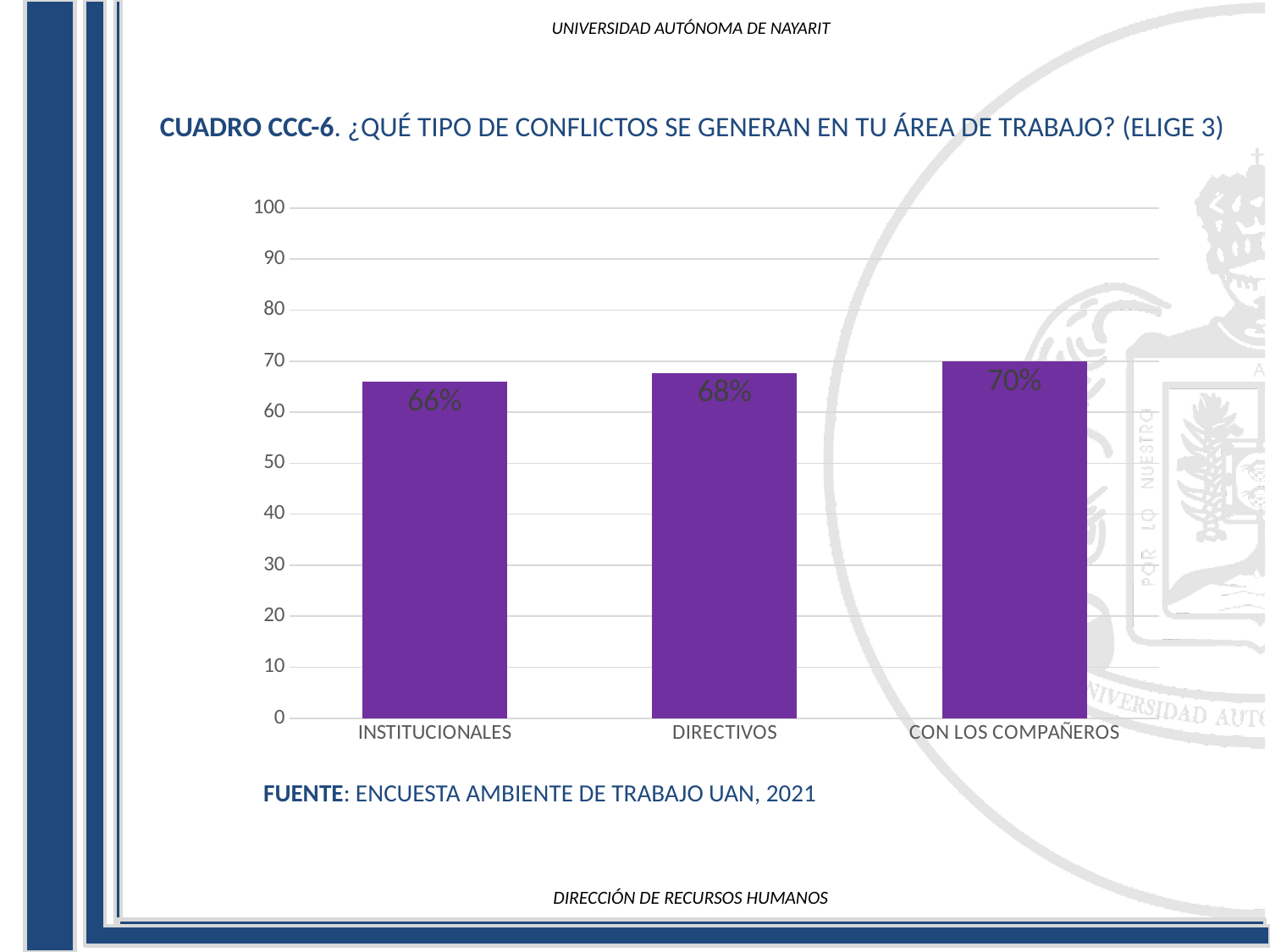
How many categories are shown on the x axis? 3 What is the value for INSTITUCIONALES? 66% Which is larger, the value for DIRECTIVOS or the value for INSTITUCIONALES? DIRECTIVOS Is the value for INSTITUCIONALES greater or less than 70? less Which category has the highest value? CON LOS COMPAÑEROS What is the value for DIRECTIVOS? 68% What kind of chart is shown on the slide? bar chart Do the values rise or fall from left to right along the x axis? rise What is the difference between the values for DIRECTIVOS and INSTITUCIONALES? 2% What is the value for CON LOS COMPAÑEROS? 70% Which category has the lowest value? INSTITUCIONALES What is the difference between the values for CON LOS COMPAÑEROS and INSTITUCIONALES? 4%